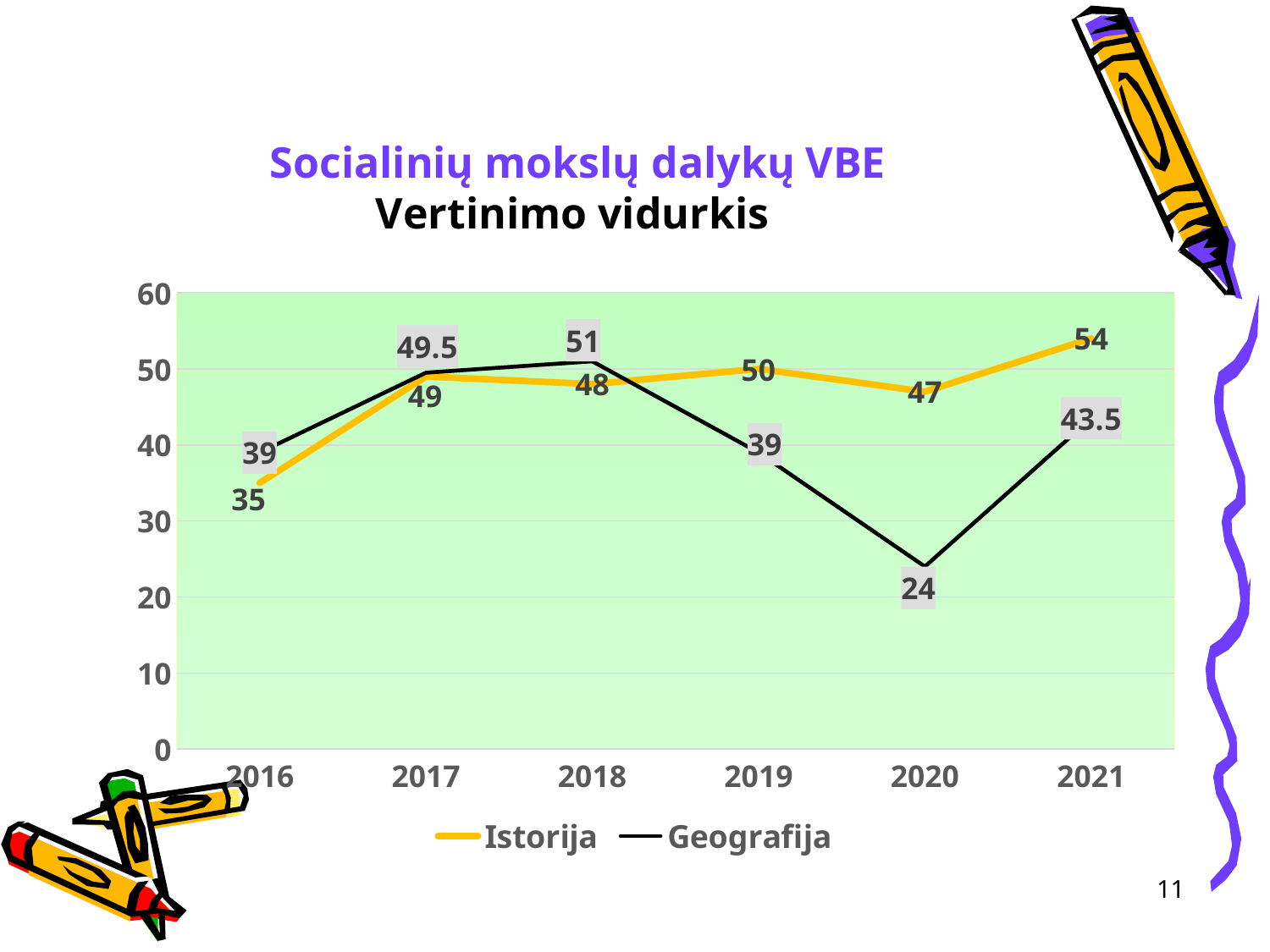
How many years are shown on the x axis? 6 In which year is the Istorija value highest? 2021 Which series is drawn in yellow? Istorija In which year is the Geografija value lowest? 2020 What is the Geografija value for 2017? 49.5 How many series does the legend list? 2 What kind of chart is shown on the slide? Line chart What is the Istorija value for 2016? 35 What is the Istorija value for 2021? 54 Which series has the higher value in 2018, Istorija or Geografija? Geografija What is the Geografija value for 2020? 24 What is the difference between the Istorija and Geografija values in 2020? 23